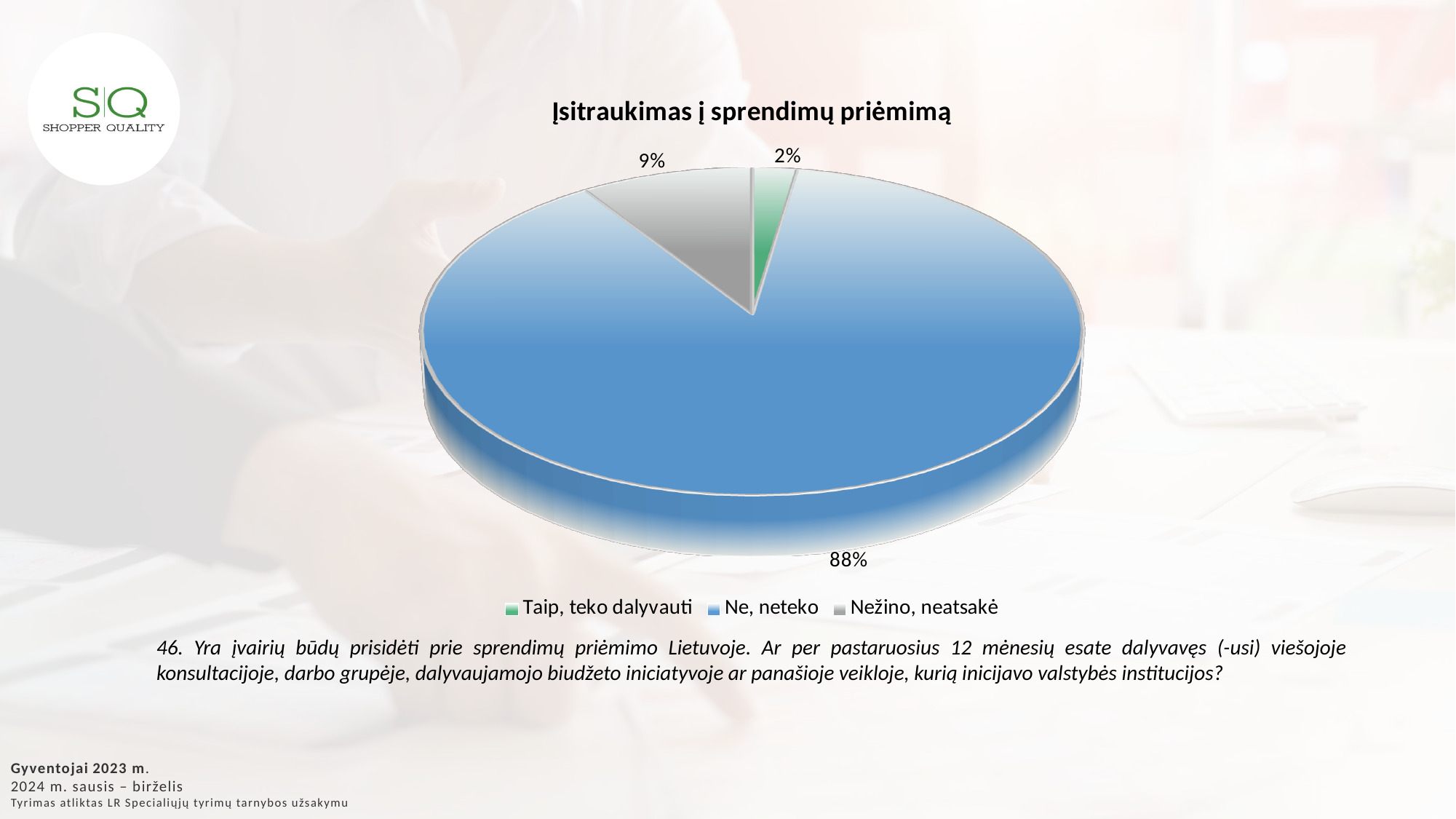
What is the difference in percentage points between "Ne, neteko" and "Nežino, neatsakė"? 79 Which is larger, the slice for "Nežino, neatsakė" or the slice for "Taip, teko dalyvauti"? Nežino, neatsakė What share of the pie is labelled "Ne, neteko"? 88% What colour is the slice for "Ne, neteko"? Blue What kind of chart is shown on the slide? Pie chart What share of the pie is labelled "Nežino, neatsakė"? 9% Which category has the largest slice of the pie? Ne, neteko Which category has the smallest slice of the pie? Taip, teko dalyvauti What is the title of the chart? Įsitraukimas į sprendimų priėmimą What share of the pie is labelled "Taip, teko dalyvauti"? 2% How many entries does the legend list? 3 How many slices does the pie chart have? 3